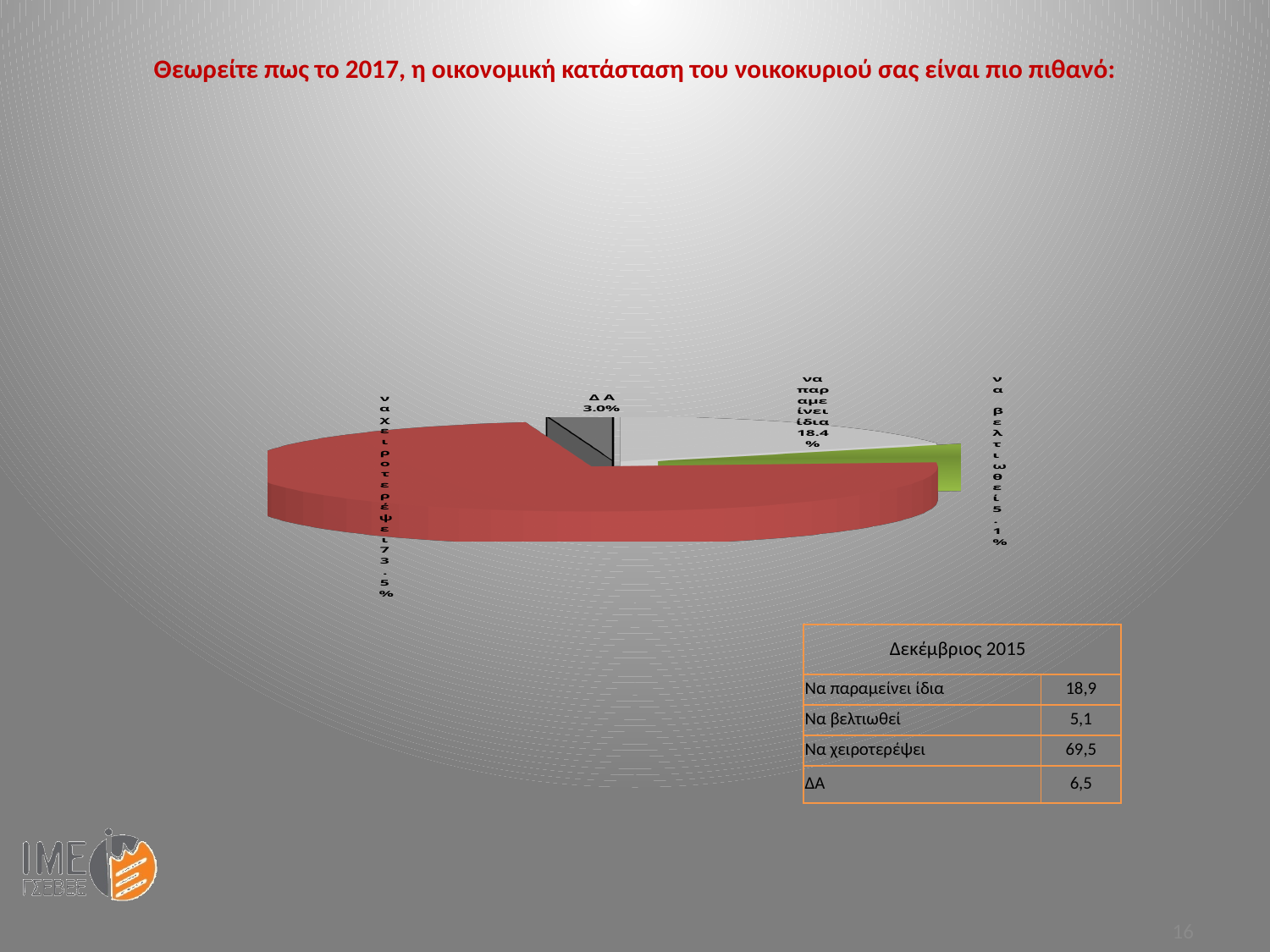
What share of the pie does "ΔΑ" have? 3.0% What kind of chart is shown on the slide? pie chart What colour is the largest slice of the pie chart? red Which slice of the pie chart is the largest? να χειροτερέψει Which is larger in the pie chart, "να παραμείνει ίδια" or "να βελτιωθεί"? να παραμείνει ίδια What is the difference in percentage points between "να βελτιωθεί" and "ΔΑ"? 2.1 What share of the pie does "να παραμείνει ίδια" have? 18.4% What share of the pie does "να βελτιωθεί" have? 5.1% What is the difference in percentage points between "να χειροτερέψει" and "να παραμείνει ίδια"? 55.1 How many slices does the pie chart have? 4 Which slice of the pie chart is the smallest? ΔΑ